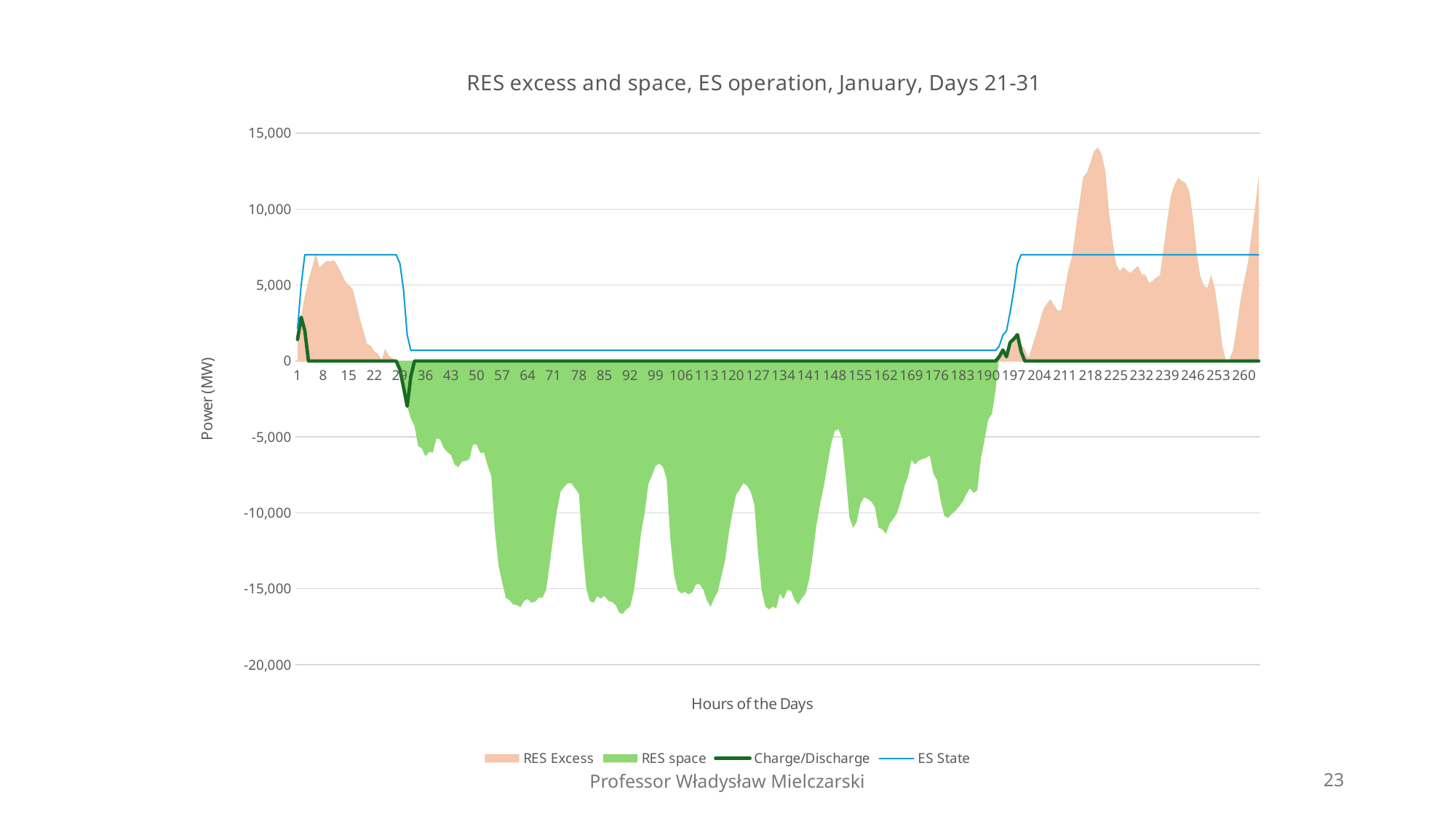
Does the ES State line rise or fall between hour 29 and hour 36? fall Which series is larger at hour 218, RES Excess or ES State? RES Excess What is the highest tick value shown on the vertical axis? 15,000 What is the label of the vertical axis? Power (MW) Does the ES State line rise or fall between hour 190 and hour 197? rise Is the ES State value at hour 211 greater or less than 5,000? greater What is the title of the chart? RES excess and space, ES operation, January, Days 21-31 Is the ES State value at hour 100 greater or less than 5,000? less How many series does the legend list? 4 Is the Charge/Discharge value around hour 29 greater or less than 0? less